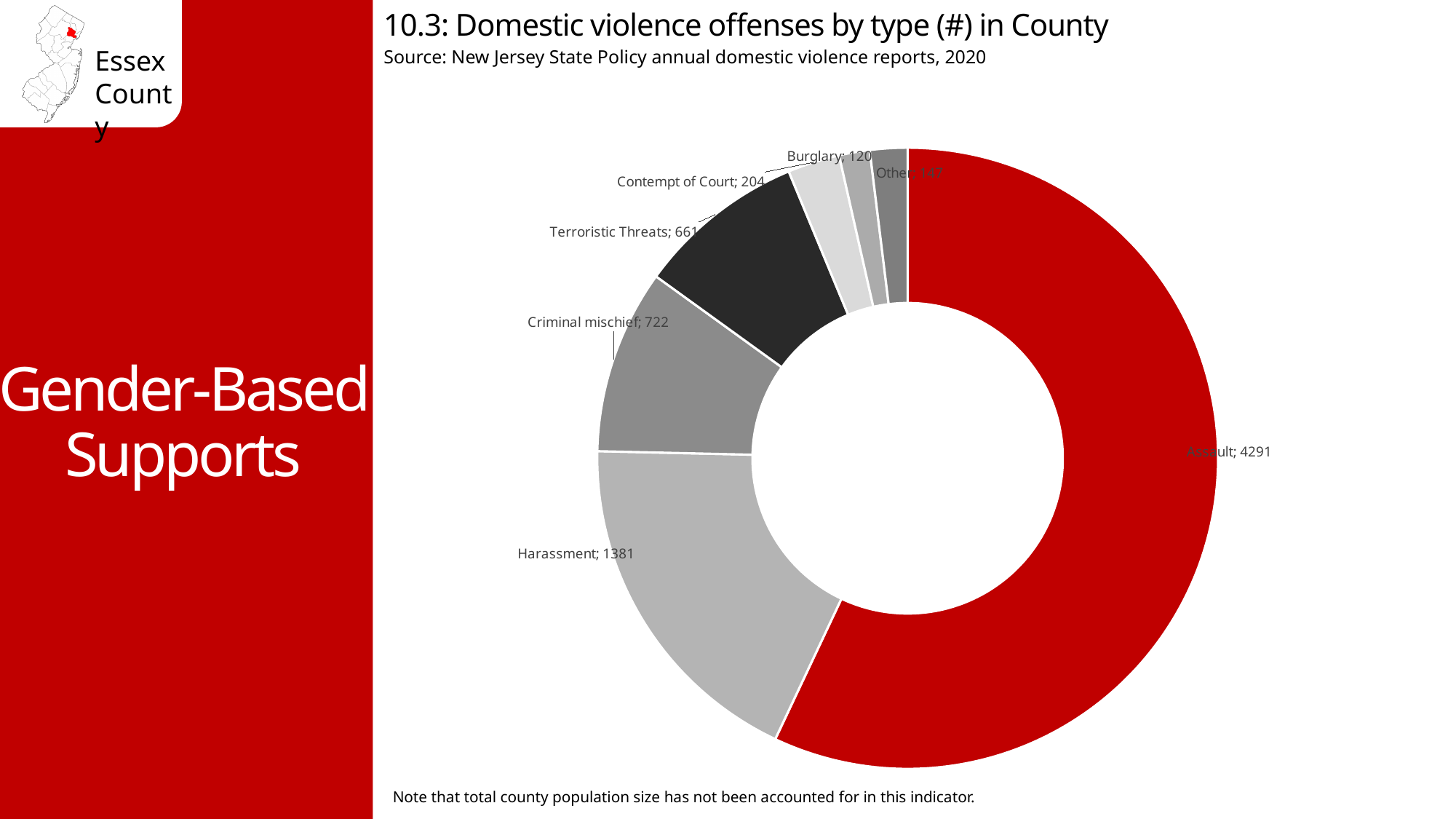
Which offense type has the largest number of offenses? Assault What is the difference between the Assault and Harassment values? 2910 What type of chart is shown on the slide? Donut (pie) chart Which is larger, Criminal mischief or Terroristic Threats? Criminal mischief Which offense type has the smallest number of offenses? Burglary What is the source cited for the chart? New Jersey State Policy annual domestic violence reports, 2020 What is the value for Criminal mischief? 722 What is the value for Harassment? 1381 What is the value for Terroristic Threats? 661 How many offense types (slices) are shown in the chart? 7 What is the value for Contempt of Court? 204 How many domestic violence offenses of type Assault are shown? 4291